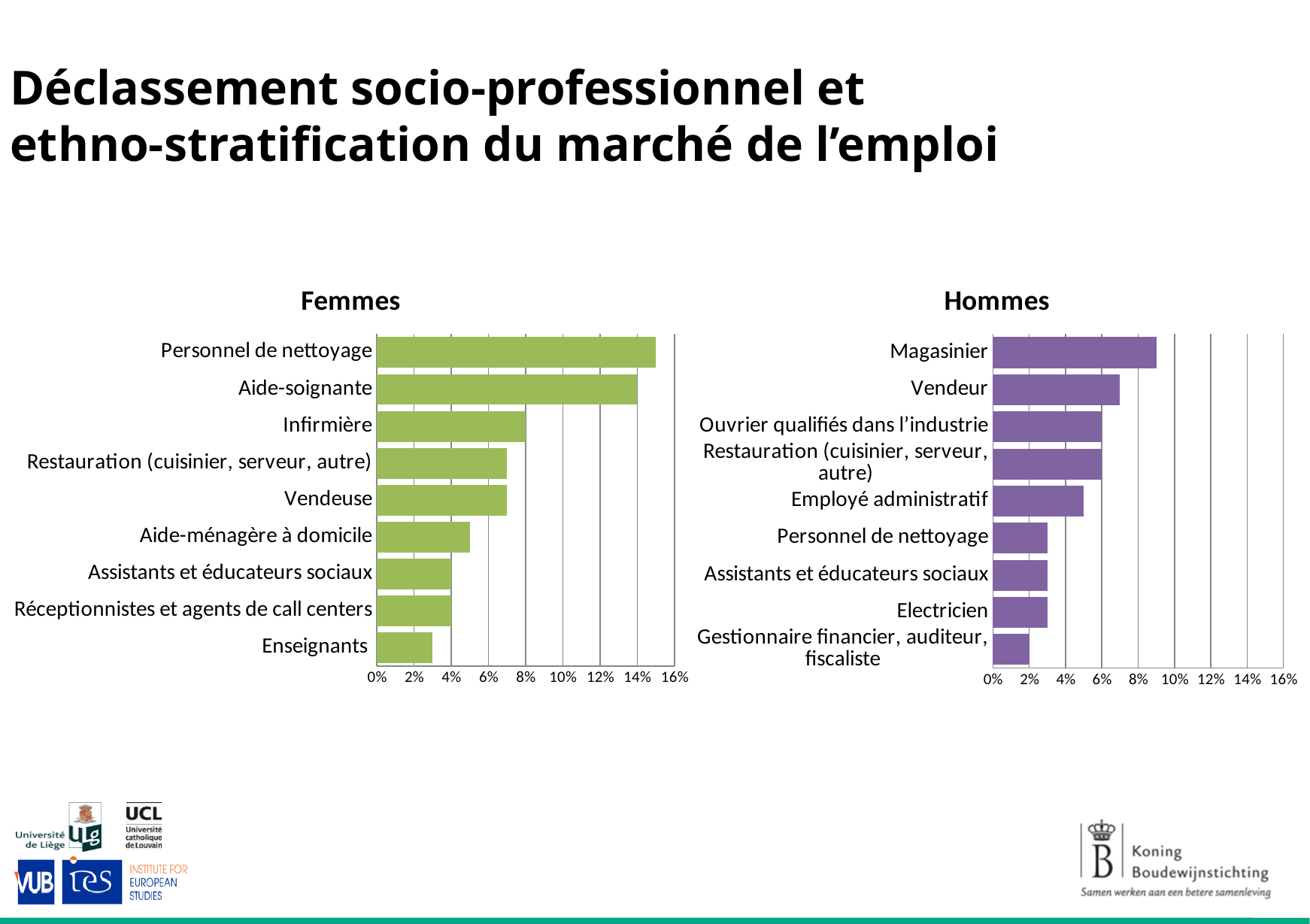
What colour are the bars in the Hommes chart? purple In the Hommes chart, which is larger: Vendeur or Electricien? Vendeur In the Femmes chart, which category has the highest value? Personnel de nettoyage In the Hommes chart, is the value for Magasinier greater or less than 10%? less In the Hommes chart, which category has the lowest value? Gestionnaire financier, auditeur, fiscaliste In the Hommes chart, which category has the highest value? Magasinier How many categories are shown in the Femmes chart? 9 In the Femmes chart, is the value for Aide-soignante greater or less than 12%? greater How many categories are shown in the Hommes chart? 9 In the Femmes chart, which is larger: Personnel de nettoyage or Infirmière? Personnel de nettoyage What kind of chart is the Femmes chart? bar chart In the Femmes chart, which category has the lowest value? Enseignants